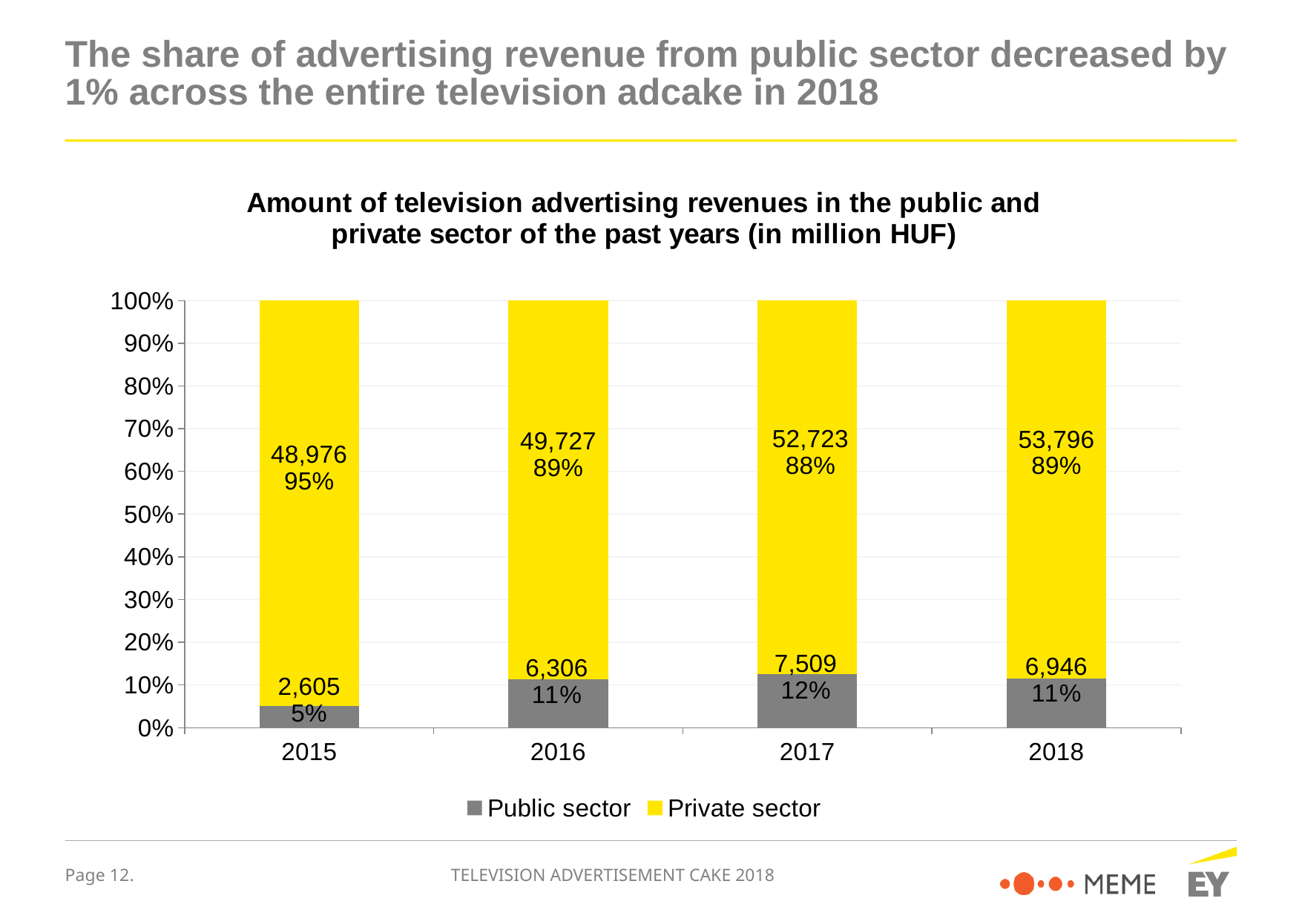
What is the Private sector value for 2015? 48,976 What is the Public sector value for 2017? 7,509 In which year is the Private sector value lowest? 2015 What kind of chart is shown on the slide? Stacked bar chart How many series does the legend list? 2 Which is larger, the Private sector value for 2016 or for 2017? 2017 What is the difference between the Public sector values for 2017 and 2018? 563 What percentage share does the Public sector have in 2015? 5% In which year is the Public sector value highest? 2017 What percentage share does the Private sector have in 2018? 89% What colour represents the Private sector in the chart? Yellow How many years are shown on the x axis? 4